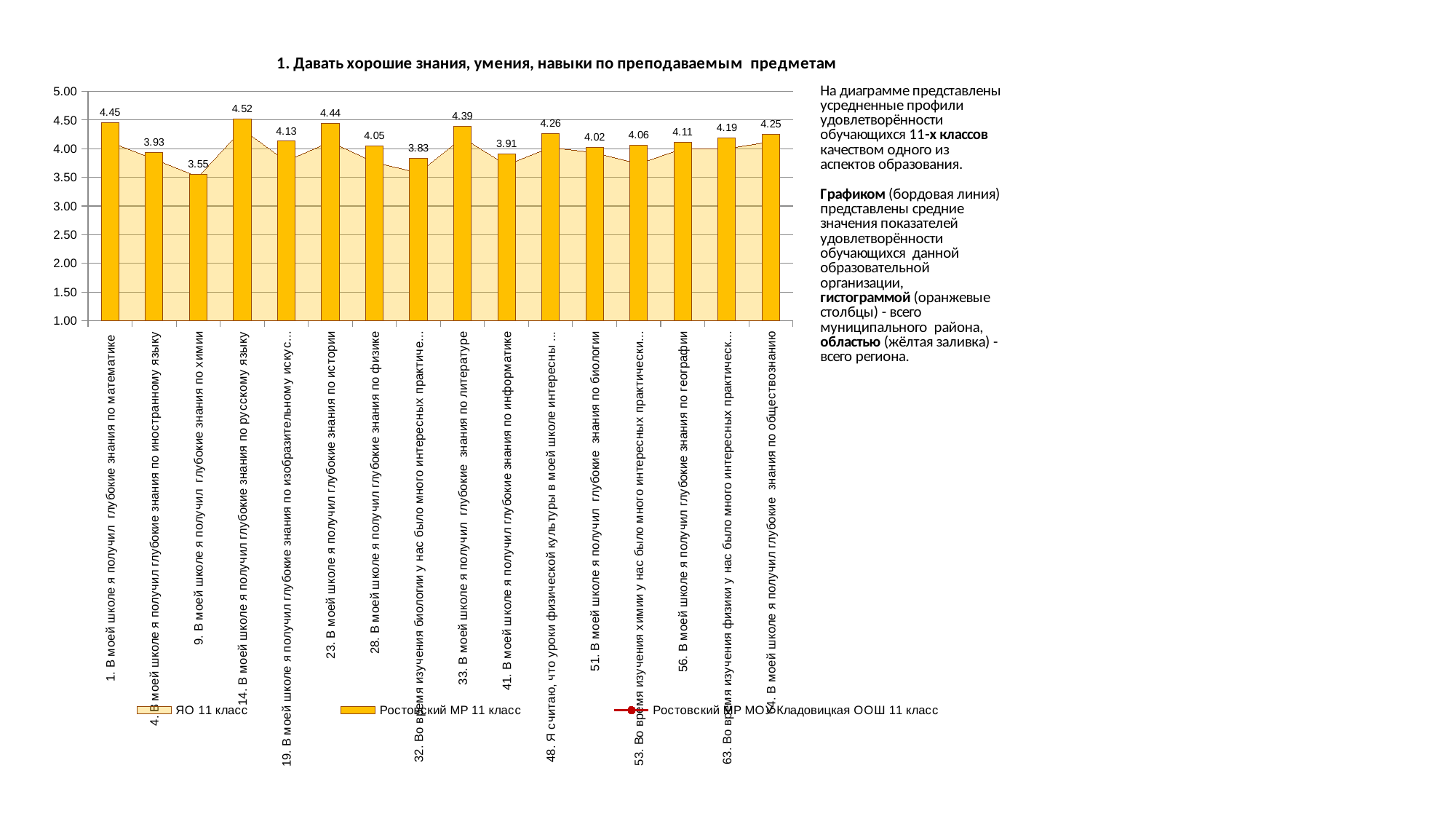
What is the value of the Ростовский МР 11 класс bar for '9. В моей школе я получил глубокие знания по химии'? 3.55 What is the title of the chart? 1. Давать хорошие знания, умения, навыки по преподаваемым предметам Which category has the highest Ростовский МР 11 класс bar? 14. В моей школе я получил глубокие знания по русскому языку How many series does the chart legend list? 3 Which category has the lowest Ростовский МР 11 класс bar? 9. В моей школе я получил глубокие знания по химии How many categories are shown on the x axis of the chart? 16 What is the value of the Ростовский МР 11 класс bar for '56. В моей школе я получил глубокие знания по географии'? 4.11 Which is larger for Ростовский МР 11 класс: the value for истории or the value for физике? истории (4.44) What is the value of the Ростовский МР 11 класс bar for '14. В моей школе я получил глубокие знания по русскому языку'? 4.52 What is the value of the Ростовский МР 11 класс bar for '1. В моей школе я получил глубокие знания по математике'? 4.45 What is the difference between the Ростовский МР 11 класс values for русскому языку (4.52) and химии (3.55)? 0.97 Is the Ростовский МР 11 класс value for '41. В моей школе я получил глубокие знания по информатике' greater or less than 4.00? less